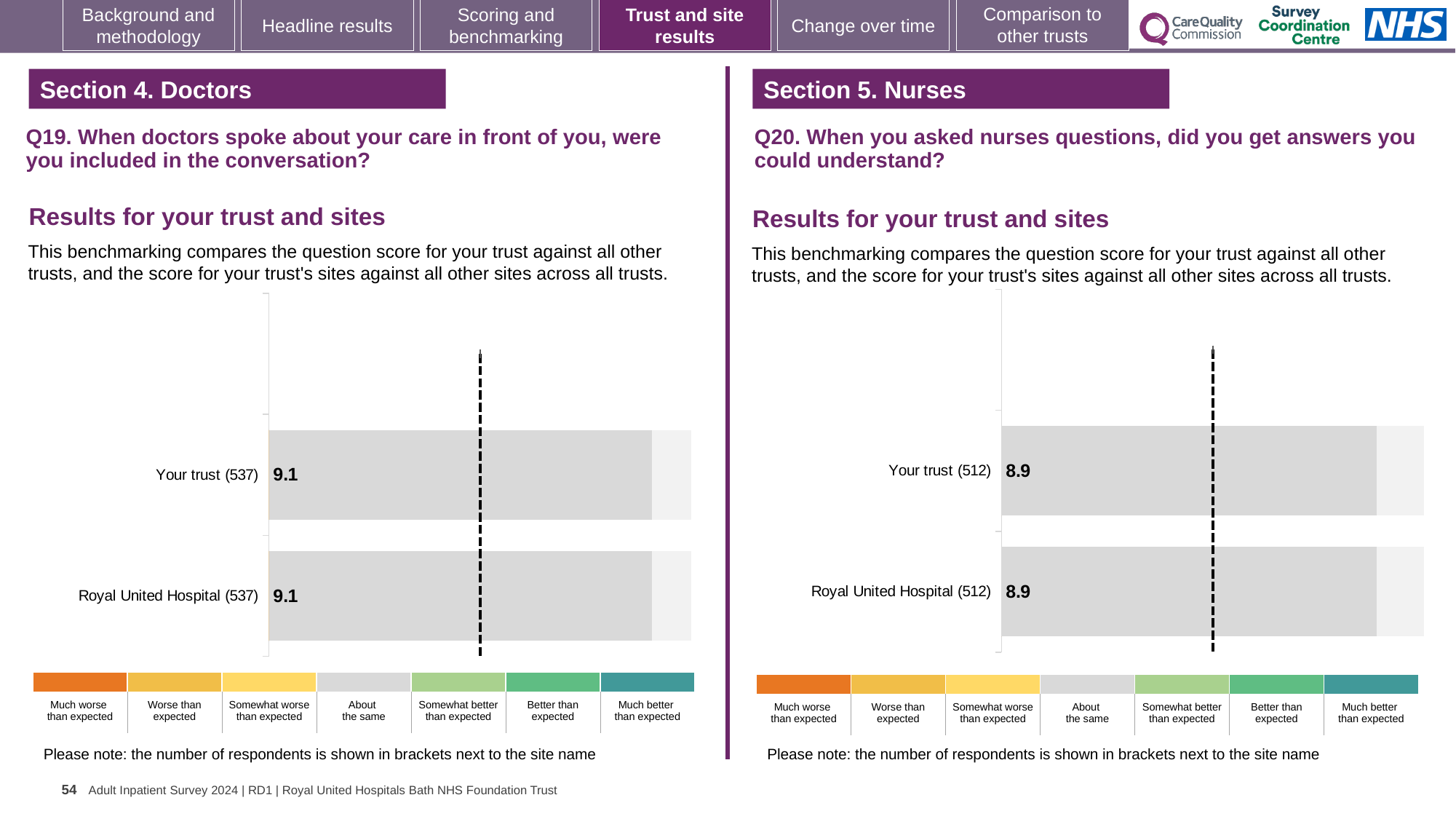
On the right chart (Q20, nurses), what is the score for Royal United Hospital? 8.9 On the left chart (Q19, doctors), how many respondents are shown in brackets next to Your trust? 537 What kind of chart is used on the left (Q19, doctors)? bar chart On the left chart (Q19, doctors), what is the score for Your trust? 9.1 On the right chart (Q20, nurses), how many respondents are shown in brackets next to Royal United Hospital? 512 On the right chart (Q20, nurses), what is the score for Your trust? 8.9 Is the Your trust score on the left chart (Q19, doctors) larger or smaller than the Your trust score on the right chart (Q20, nurses)? larger On the right chart (Q20, nurses), what is the difference between the Your trust score and the Royal United Hospital score? 0 How many bars are plotted on the right chart (Q20, nurses)? 2 On the left chart (Q19, doctors), what is the score for Royal United Hospital? 9.1 On the left chart (Q19, doctors), what is the difference between the Your trust score and the Royal United Hospital score? 0 How many bars are plotted on the left chart (Q19, doctors)? 2